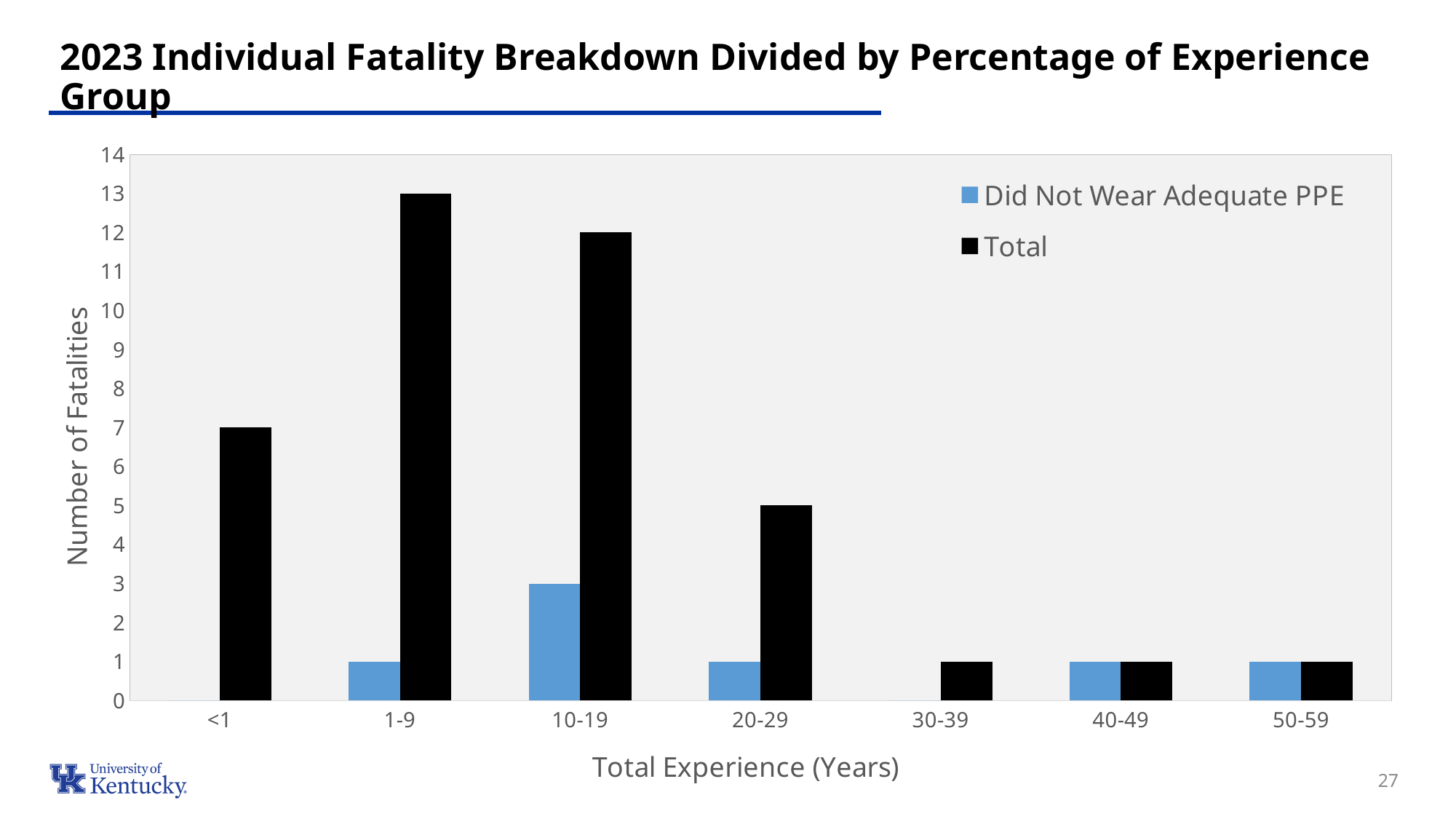
How many series does the legend list? 2 What is the difference between the Total fatalities and the Did Not Wear Adequate PPE fatalities for the 20-29 group? 4 What type of chart is shown on the slide? Bar chart What is the Total number of fatalities for the <1 year experience group? 7 Which experience group has the highest number of fatalities that Did Not Wear Adequate PPE? 10-19 How many fatalities in the 10-19 years group Did Not Wear Adequate PPE? 3 How many experience groups are shown on the x axis? 7 Is the Total number of fatalities for the 10-19 group greater or less than 10? greater Which experience group has the highest Total number of fatalities? 1-9 What is the Total number of fatalities for the 1-9 years experience group? 13 Which is larger: the Total fatalities for the <1 group or for the 20-29 group? <1 What is the difference between the Total fatalities for the 1-9 group and the 10-19 group? 1